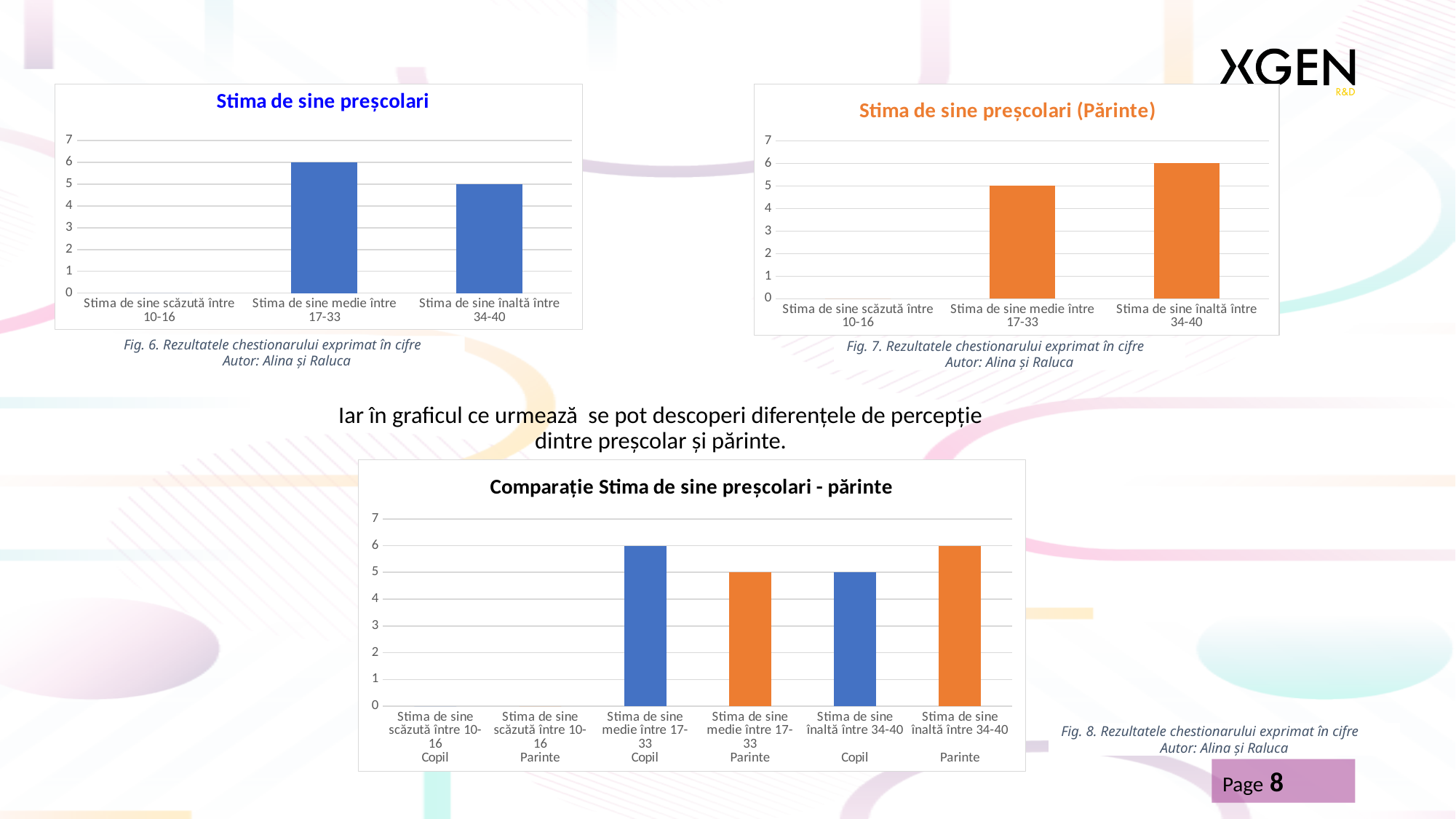
What kind of chart is the chart titled 'Comparație Stima de sine preșcolari - părinte'? Bar chart In the chart titled 'Stima de sine preșcolari', how many categories are shown on the x axis? 3 In the chart titled 'Comparație Stima de sine preșcolari - părinte', how many categories are shown on the x axis? 6 In the chart titled 'Stima de sine preșcolari (Părinte)', which category has the highest value? Stima de sine înaltă între 34-40 In the chart titled 'Stima de sine preșcolari (Părinte)', what is the difference between 'Stima de sine înaltă între 34-40' and 'Stima de sine medie între 17-33'? 1 In the chart titled 'Stima de sine preșcolari', what is the value for 'Stima de sine înaltă între 34-40'? 5 In the chart titled 'Comparație Stima de sine preșcolari - părinte', which is larger: 'Stima de sine înaltă între 34-40 Copil' or 'Stima de sine înaltă între 34-40 Parinte'? Stima de sine înaltă între 34-40 Parinte In the chart titled 'Stima de sine preșcolari (Părinte)', what is the value for 'Stima de sine medie între 17-33'? 5 In the chart titled 'Stima de sine preșcolari (Părinte)', what is the value for 'Stima de sine înaltă între 34-40'? 6 In the chart titled 'Stima de sine preșcolari', which category has the highest value? Stima de sine medie între 17-33 In the chart titled 'Comparație Stima de sine preșcolari - părinte', what is the value for 'Stima de sine medie între 17-33 Copil'? 6 In the chart titled 'Stima de sine preșcolari', what is the value for 'Stima de sine medie între 17-33'? 6